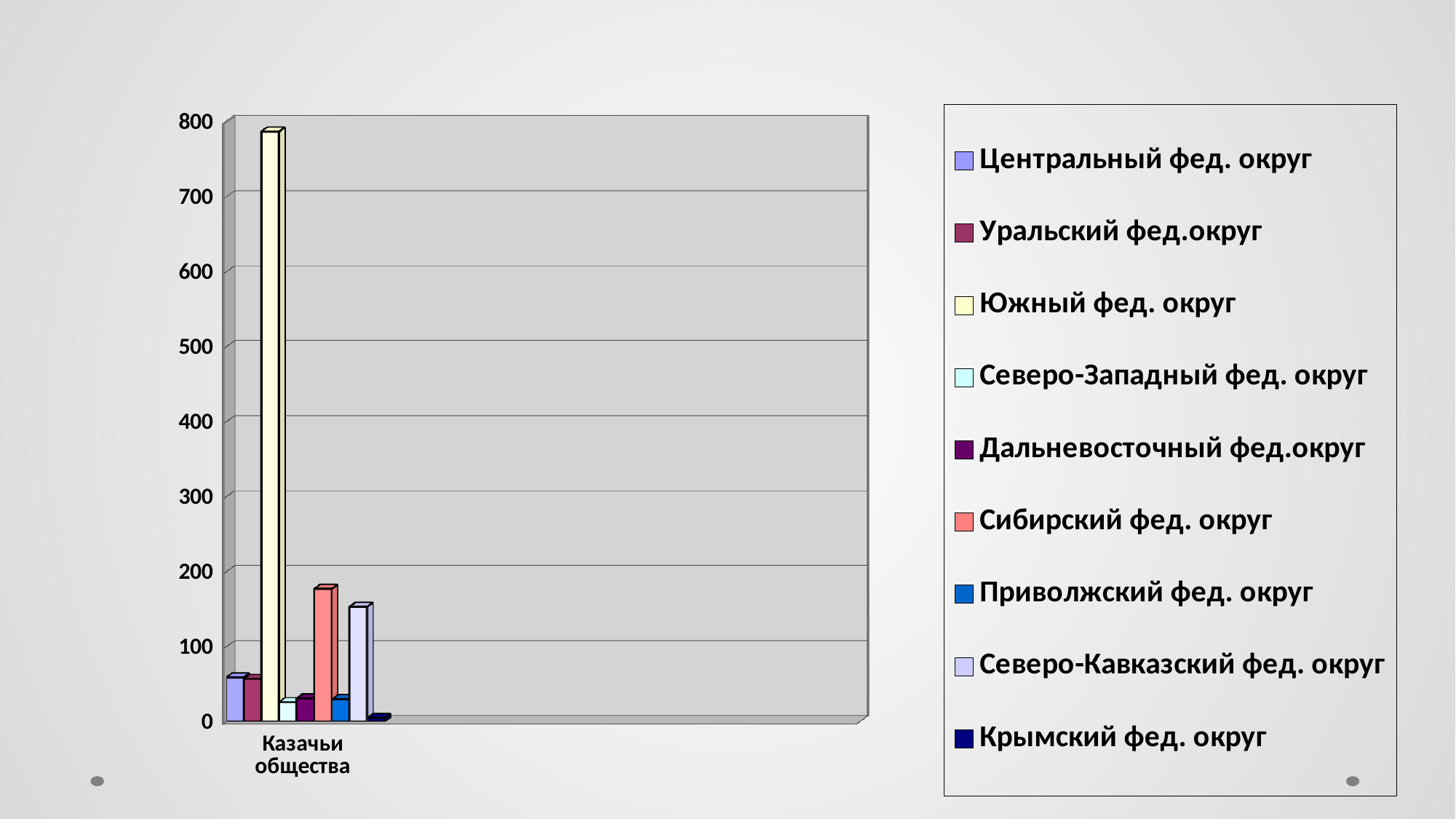
Is the value for Северо-Кавказский фед. округ greater or less than 100? greater Is the value for Сибирский фед. округ greater or less than 200? less Which series has the highest value? Южный фед. округ How many categories are shown on the x axis? 1 Which series is shown in dark navy blue in the legend? Крымский фед. округ What kind of chart is shown on the slide? bar chart Which is larger, the value for Сибирский фед. округ or the value for Северо-Кавказский фед. округ? Сибирский фед. округ How many series does the legend list? 9 Is the value for Центральный фед. округ greater or less than 100? less What is the label of the category on the x axis? Казачьи общества Which series has the lowest value? Крымский фед. округ